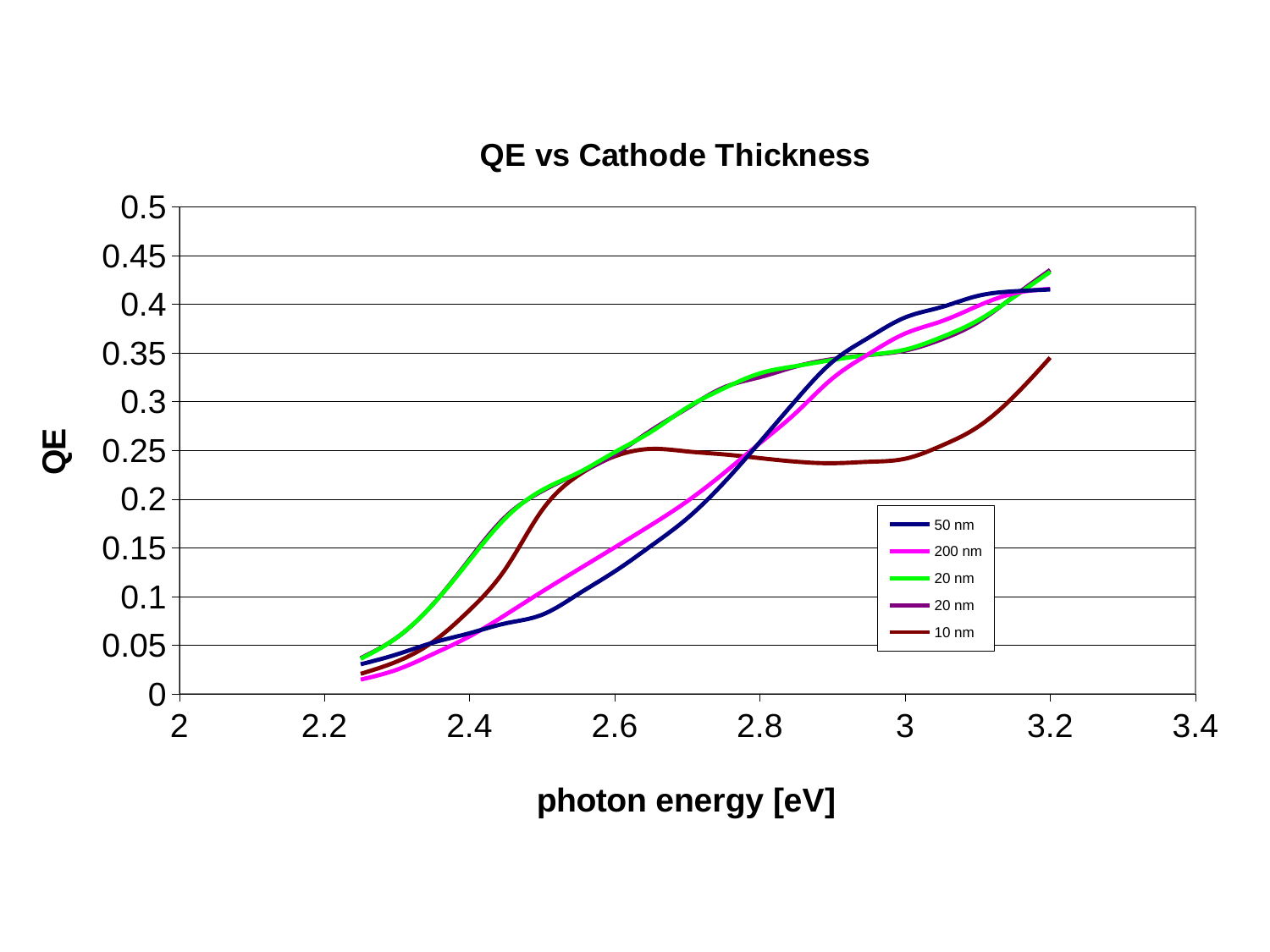
How many series does the legend list? 5 Is the QE value for the 10 nm series at 3.2 eV greater or less than 0.3? greater At 2.6 eV, which series has a higher QE, 20 nm or 50 nm? 20 nm At 3.2 eV, which series has a higher QE, 10 nm or 50 nm? 50 nm What is the title of the chart? QE vs Cathode Thickness Is the QE value for the 50 nm series at 3.2 eV greater or less than 0.4? greater Is the QE value for the 10 nm series at 3 eV greater or less than 0.3? less Which series has the lowest QE at 3.2 eV? 10 nm What kind of chart is shown on the slide? line chart Does the QE of the 50 nm series rise or fall as photon energy increases from 2.2 to 3.2 eV? rise What is the label of the x axis? photon energy [eV]